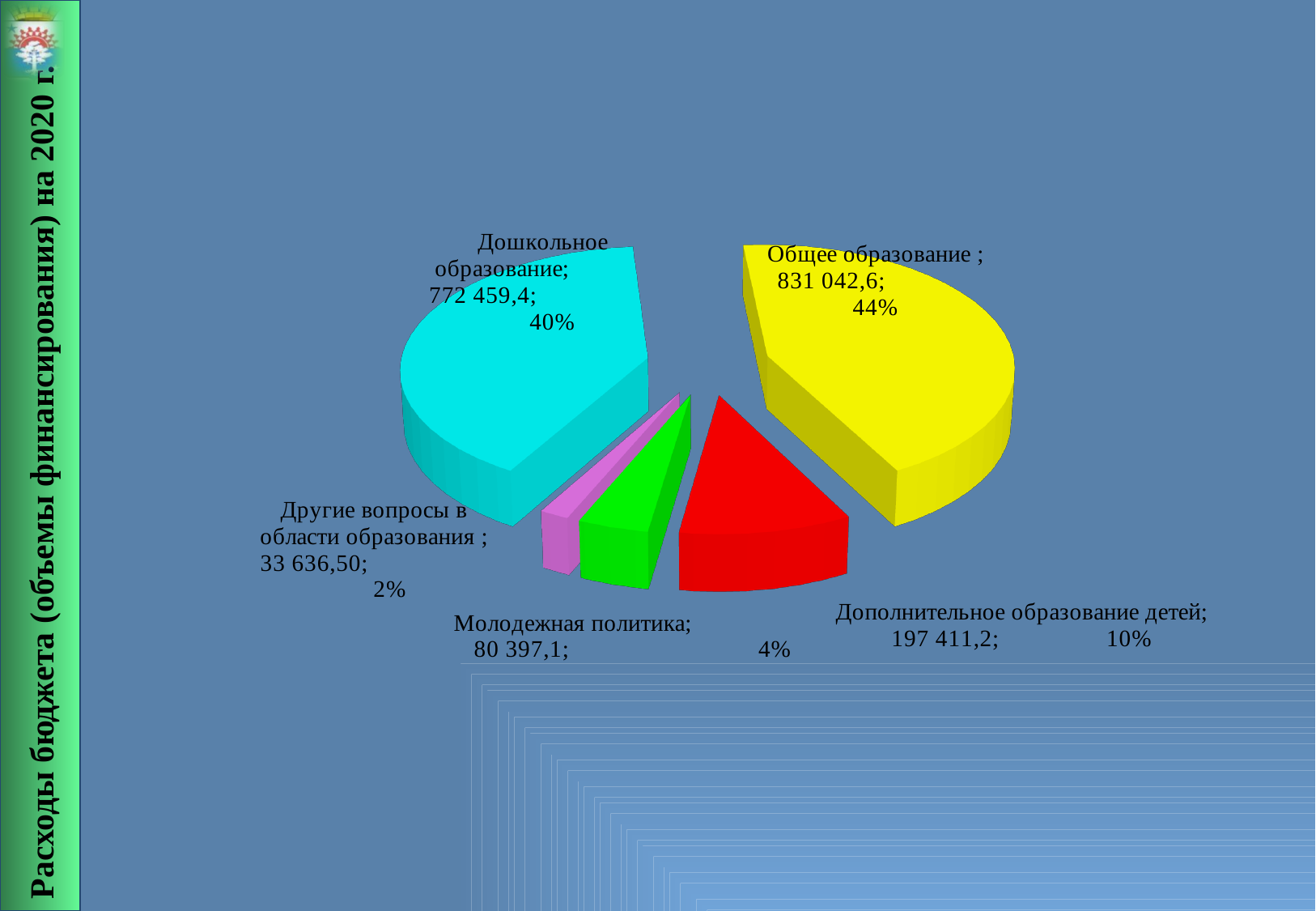
Which category has the largest share of the pie? Общее образование Which is larger, the value for Молодежная политика or the value for Другие вопросы в области образования? Молодежная политика What is the value for Общее образование? 831 042,6 Which category has the smallest share of the pie? Другие вопросы в области образования What kind of chart is shown on the slide? pie chart What is the value for Дошкольное образование? 772 459,4 How many slices does the pie chart have? 5 What is the value for Молодежная политика? 80 397,1 What share of the pie does Дополнительное образование детей represent? 10% What is the value for Дополнительное образование детей? 197 411,2 What is the value for Другие вопросы в области образования? 33 636,50 What colour is the slice for Общее образование? yellow